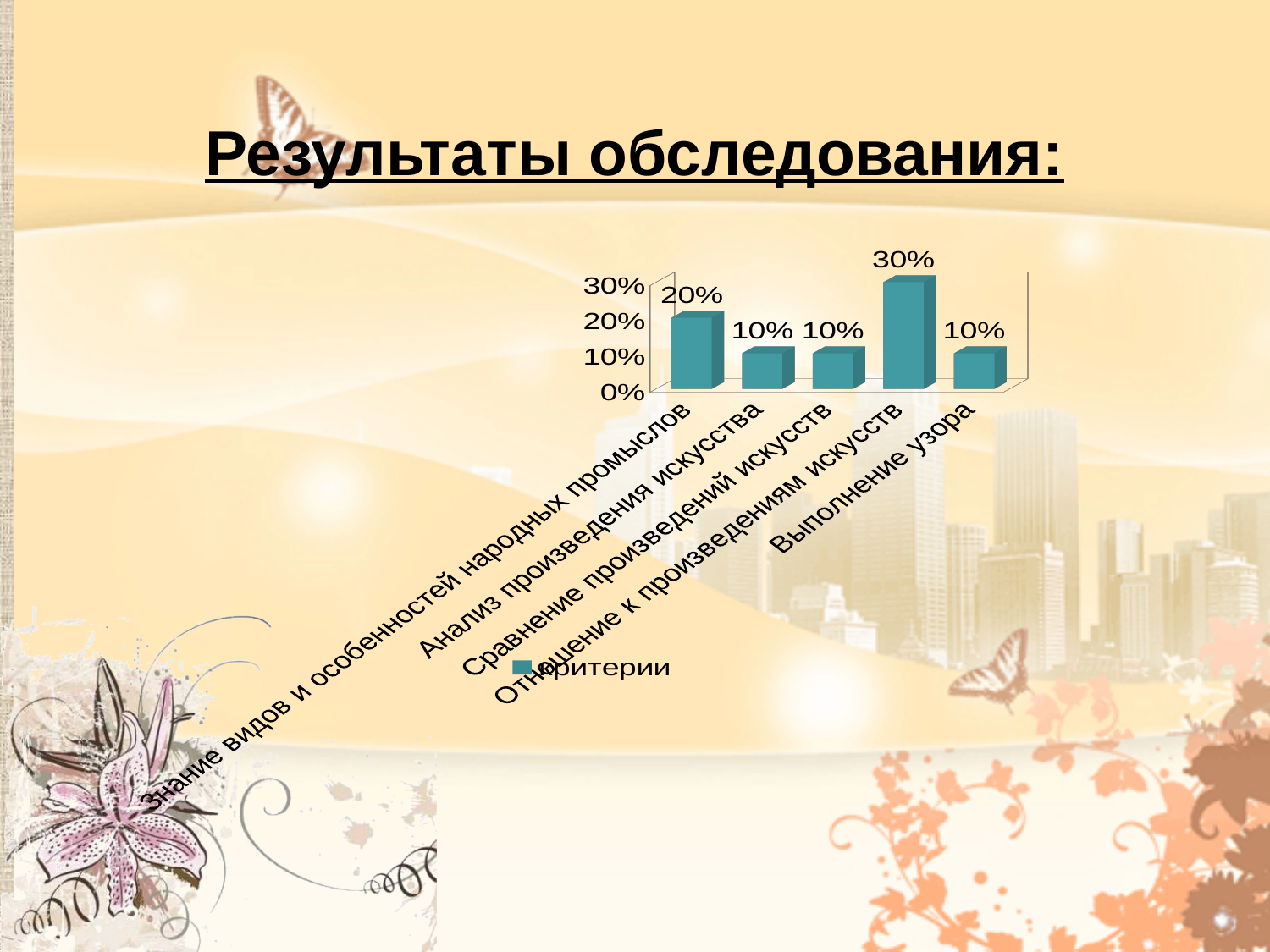
What value is shown for "Отношение к произведениям искусств"? 30% What value is shown for "Знание видов и особенностей народных промыслов"? 20% How many series does the legend list? 1 Which is larger: the value for "Отношение к произведениям искусств" or the value for "Выполнение узора"? Отношение к произведениям искусств What kind of chart is shown on the slide? Bar chart What value is shown for "Выполнение узора"? 10% What is the name of the series shown in the legend? критерии What is the difference between the values for "Знание видов и особенностей народных промыслов" and "Сравнение произведений искусств"? 10% What is the difference between the values for "Отношение к произведениям искусств" and "Знание видов и особенностей народных промыслов"? 10% Which category has the highest value? Отношение к произведениям искусств How many categories are shown on the chart? 5 What value is shown for "Анализ произведения искусства"? 10%